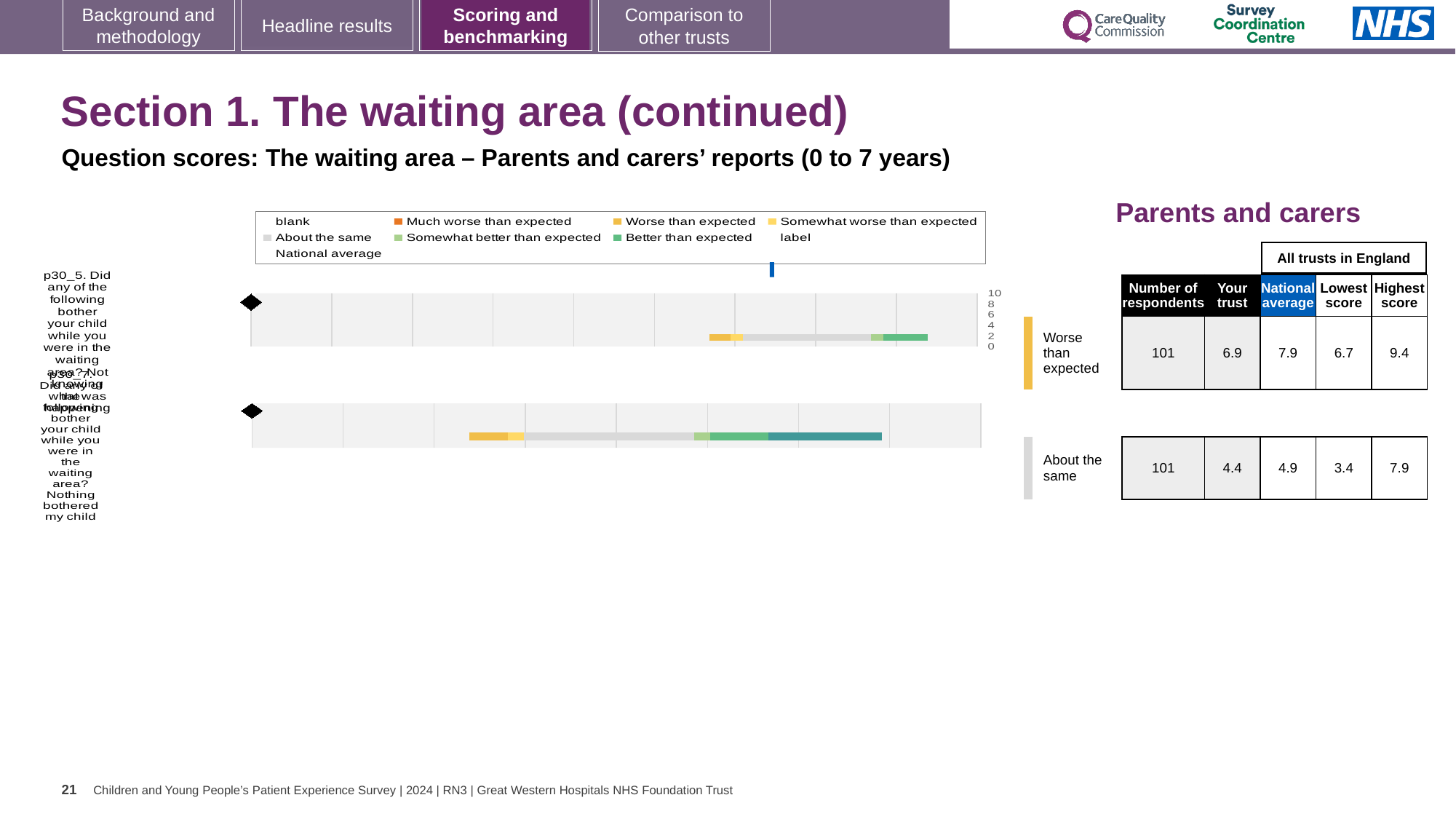
What kind of chart is shown on the slide? bar chart What colour does the legend use for 'Much worse than expected'? orange In the table, what is the national average for the row labelled 'Worse than expected'? 7.9 In the table, what is the highest score among all trusts in England for the 'About the same' row? 7.9 For the 'Worse than expected' row, which is larger: the 'Your trust' score or the national average? National average In the table, what is the 'Your trust' score for the row labelled 'About the same'? 4.4 In the table, how many respondents are listed for the 'Worse than expected' row? 101 What is the highest value shown on the chart's numeric axis? 10 In the table, what is the 'Your trust' score for the row labelled 'Worse than expected'? 6.9 For the 'Worse than expected' row, what is the difference between the national average and the 'Your trust' score? 1.0 For the 'About the same' row, what is the difference between the highest score and the lowest score? 4.5 How many question bars are plotted in the chart? 2